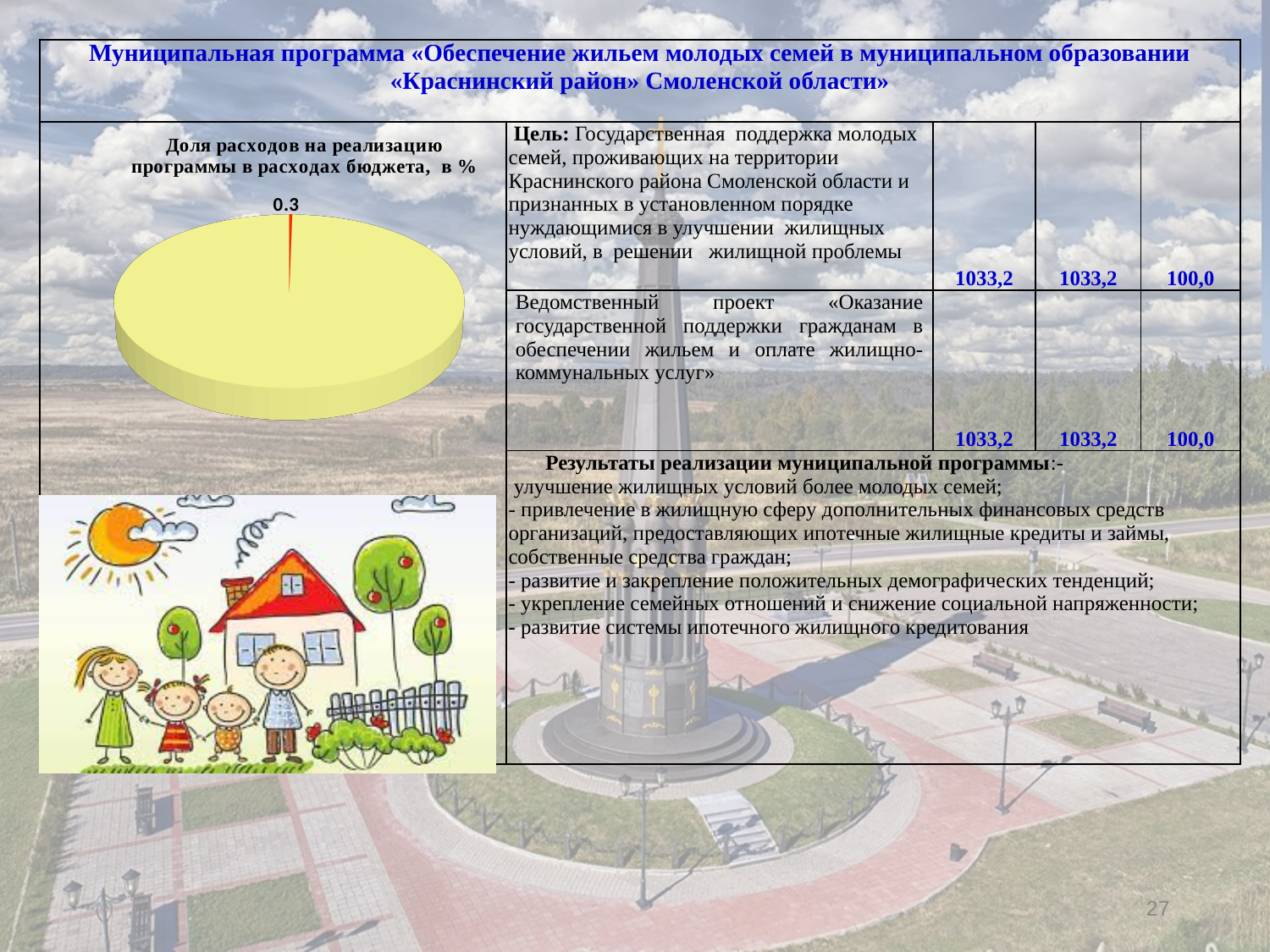
What kind of chart is shown on the slide? pie chart Which slice of the pie chart is larger, the yellow one or the red one? the yellow one What share of the budget expenditures does the program account for, according to the pie chart's data label? 0.3 Is the labeled slice of the pie chart greater or less than 1? less What colour is the large slice of the pie chart? yellow What is the title of the pie chart? Доля расходов на реализацию программы в расходах бюджета, в % What value is printed as the data label on the pie chart? 0.3 Which slice of the pie chart is the smallest? the red slice labeled 0.3 How many slices does the pie chart show? 2